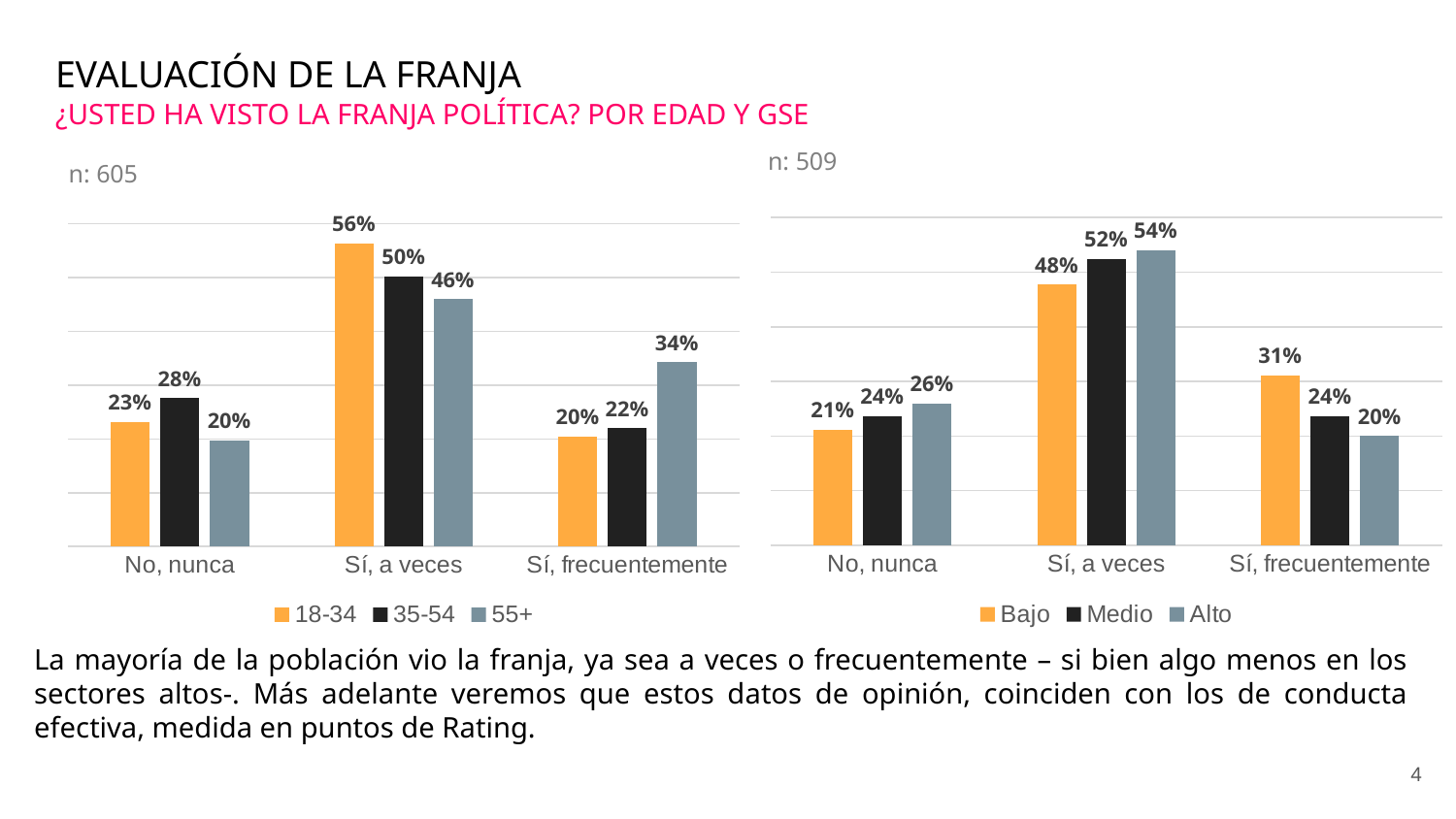
In the right chart (by GSE, n: 509), what is the value for Alto in the 'Sí, a veces' category? 54% In the right chart (by GSE), which group has the lowest value for 'No, nunca'? Bajo In the left chart (by age), which is larger for 'No, nunca': the value for 35-54 or the value for 55+? 35-54 In the left chart (by age, n: 605), what is the value for 18-34 in the 'Sí, a veces' category? 56% In the left chart (by age), what is the difference between the 18-34 and 55+ values for 'Sí, a veces'? 10% In the right chart (by GSE), what is the difference between the Bajo and Alto values for 'Sí, frecuentemente'? 11% In the left chart (by age), which age group has the highest value for 'Sí, frecuentemente'? 55+ How many categories are shown on the x axis of the left chart (by age)? 3 What kind of chart is the left chart (by age)? Bar chart What are the legend entries of the left chart (by age)? 18-34, 35-54, 55+ In the right chart (by GSE), which is larger for 'Sí, frecuentemente': the value for Bajo or the value for Medio? Bajo How many series does the legend of the right chart (by GSE) list? 3